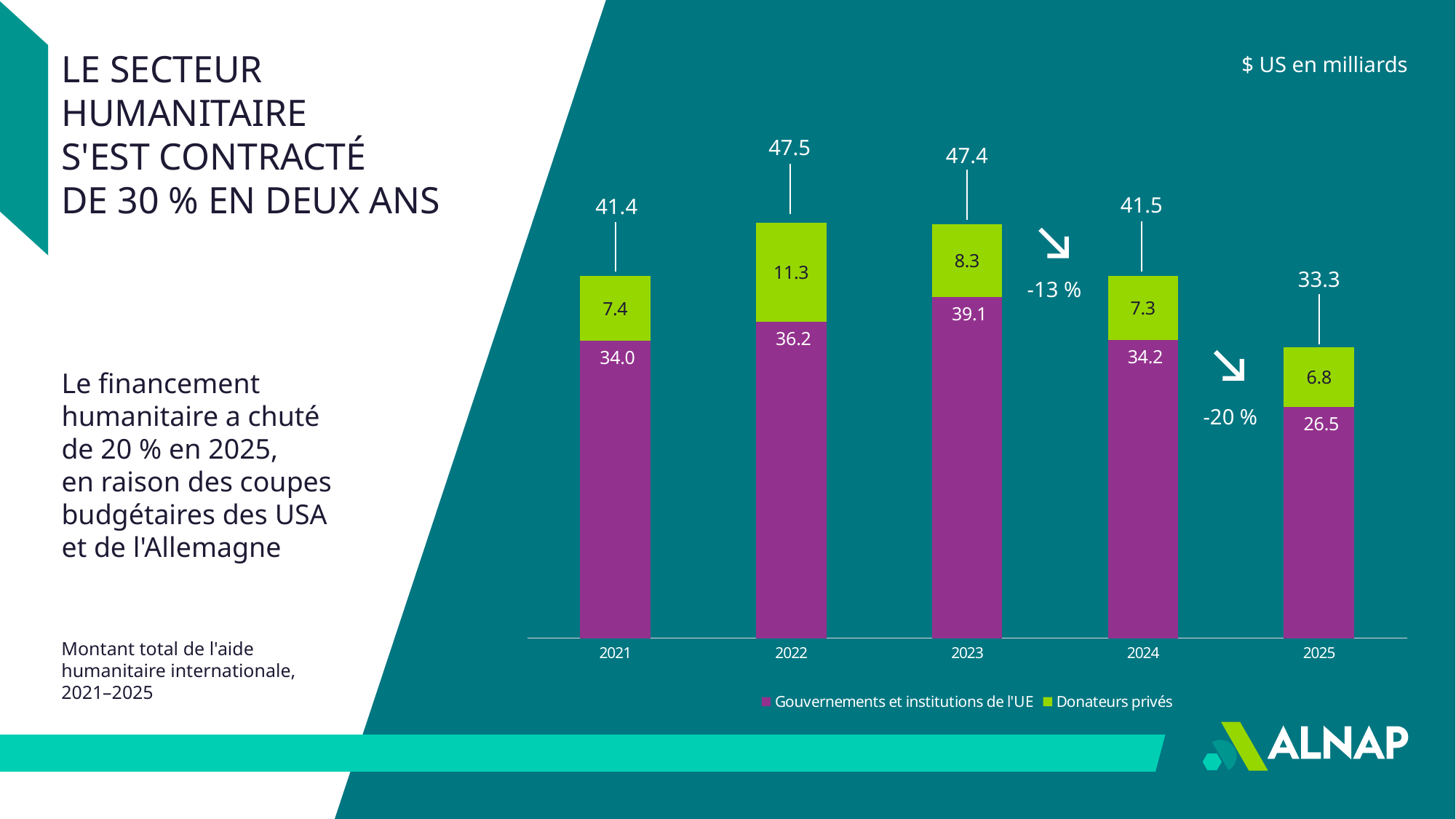
Which year has the highest total? 2022 Which year has the lowest total? 2025 How many years are shown on the x axis? 5 What unit is indicated at the top right of the chart? $ US en milliards What kind of chart is shown? Stacked bar chart What is the difference between the Donateurs privés values for 2022 and 2021? 3.9 Which is larger: the Gouvernements et institutions de l'UE value for 2024 or for 2025? 2024 What is the value for Gouvernements et institutions de l'UE in 2023? 39.1 What is the total of the stacked bar for 2025? 33.3 What is the value for Donateurs privés in 2022? 11.3 How many series does the legend list? 2 Do the totals rise or fall from 2023 to 2025? Fall